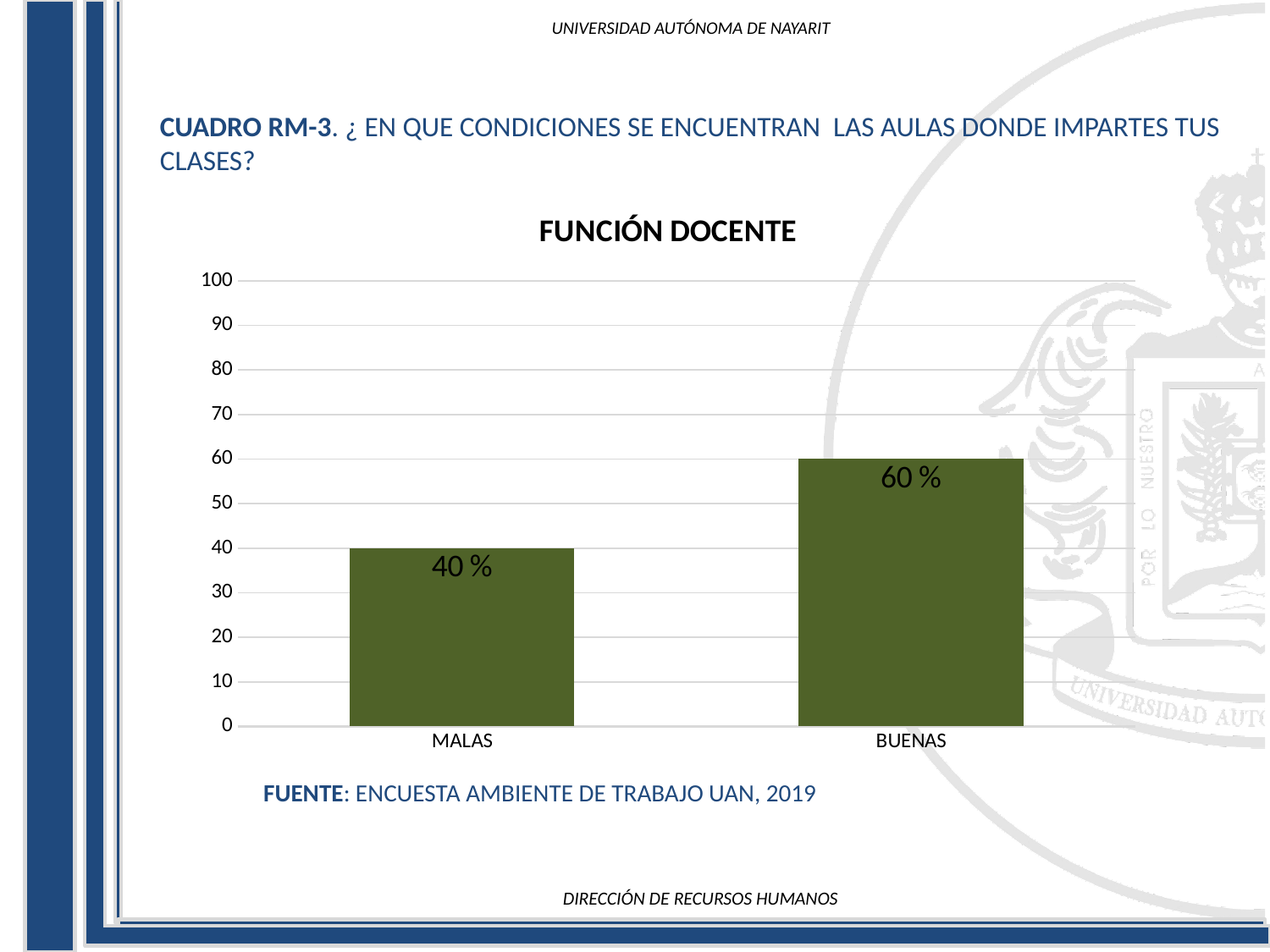
What is the difference between the values for BUENAS and MALAS? 20 % Is the value for BUENAS greater or less than 50? greater What kind of chart is shown on the slide? bar chart What is the value for MALAS? 40 % Which category has the lowest value? MALAS What is the value for BUENAS? 60 % Is the value for MALAS greater or less than 50? less Which is larger, the value for MALAS or the value for BUENAS? BUENAS What is the highest value shown on the y axis? 100 What is the title of the chart? FUNCIÓN DOCENTE Which category has the highest value? BUENAS How many categories are shown on the x axis? 2